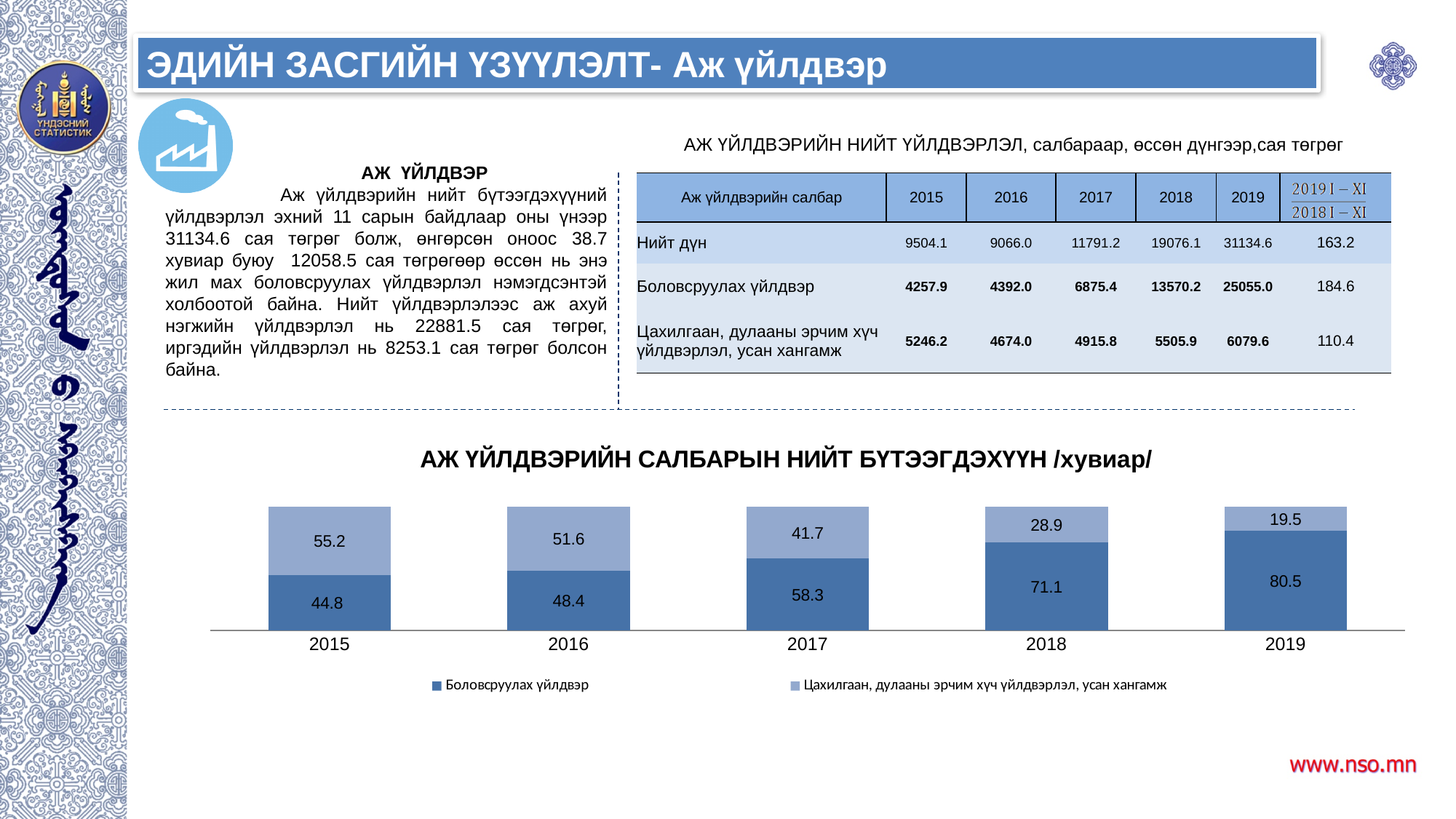
How many series does the chart legend list? 2 What is the value for Цахилгаан, дулааны эрчим хүч үйлдвэрлэл, усан хангамж in 2019? 19.5 In which year is the value for Боловсруулах үйлдвэр highest? 2019 What is the total of the stacked bar for 2018? 100 What is the difference between the Боловсруулах үйлдвэр values for 2019 and 2015? 35.7 Does the value for Боловсруулах үйлдвэр rise or fall from 2015 to 2019? rise In which year is the value for Цахилгаан, дулааны эрчим хүч үйлдвэрлэл, усан хангамж lowest? 2019 What is the value for Боловсруулах үйлдвэр in 2017? 58.3 What is the value for Боловсруулах үйлдвэр in 2015? 44.8 How many years are shown on the x axis of the chart? 5 Which is larger in 2016: Боловсруулах үйлдвэр or Цахилгаан, дулааны эрчим хүч үйлдвэрлэл, усан хангамж? Цахилгаан, дулааны эрчим хүч үйлдвэрлэл, усан хангамж What type of chart is shown on the slide? stacked bar chart